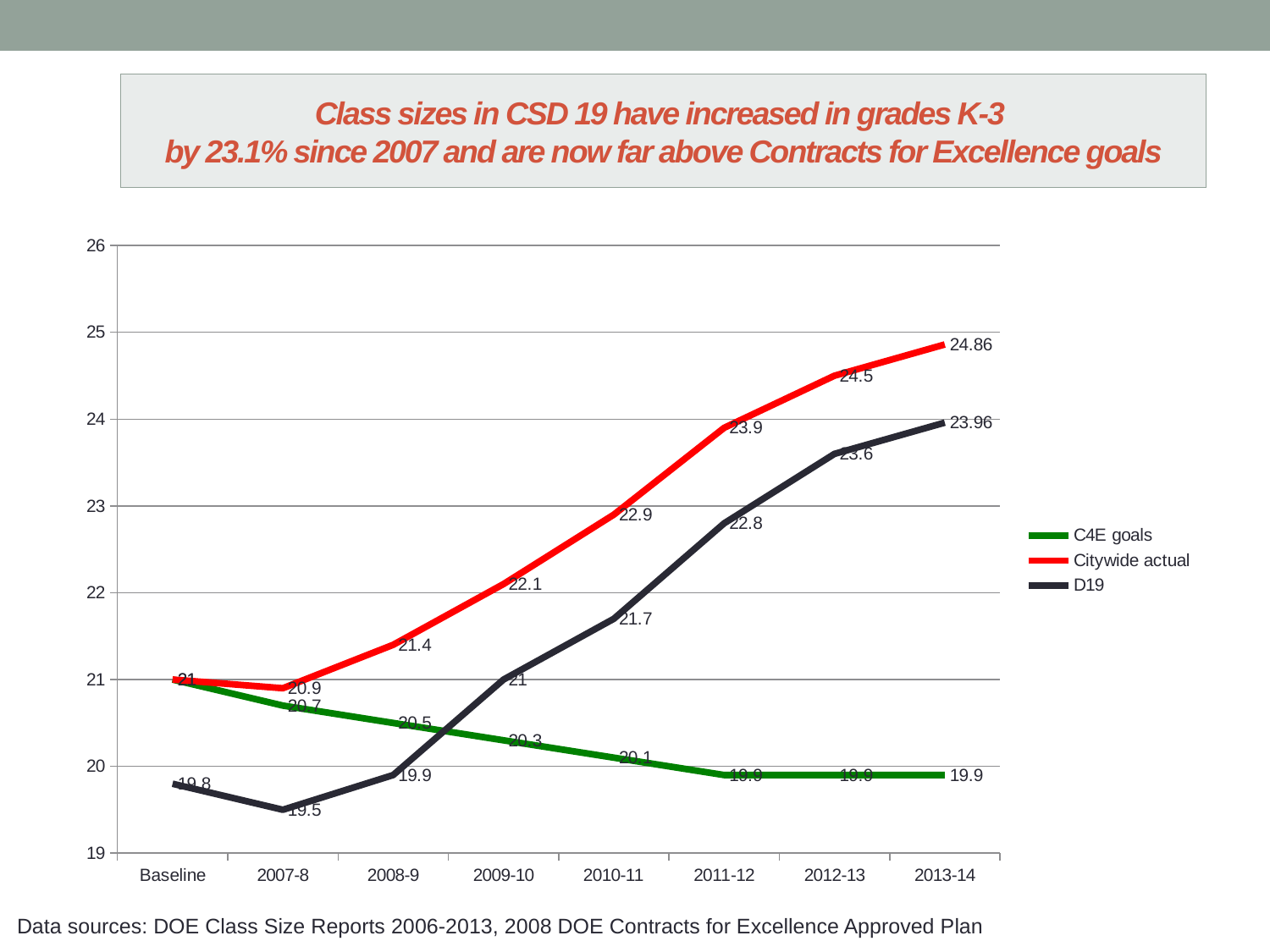
How many points are plotted along the x axis for each series? 8 Is the Citywide actual value for 2012-13 greater or less than 24? greater What is the difference between the Citywide actual and D19 values in 2013-14? 0.9 What is the D19 value for 2013-14? 23.96 Do the D19 values rise or fall from 2008-9 to 2013-14? rise How many series does the legend list? 3 What is the Citywide actual value for 2013-14? 24.86 What kind of chart is shown on the slide? line chart In which year is the D19 value lowest? 2007-8 What is the D19 value for 2007-8? 19.5 What is the Citywide actual value for 2011-12? 23.9 In 2010-11, which is larger: the Citywide actual value or the D19 value? Citywide actual